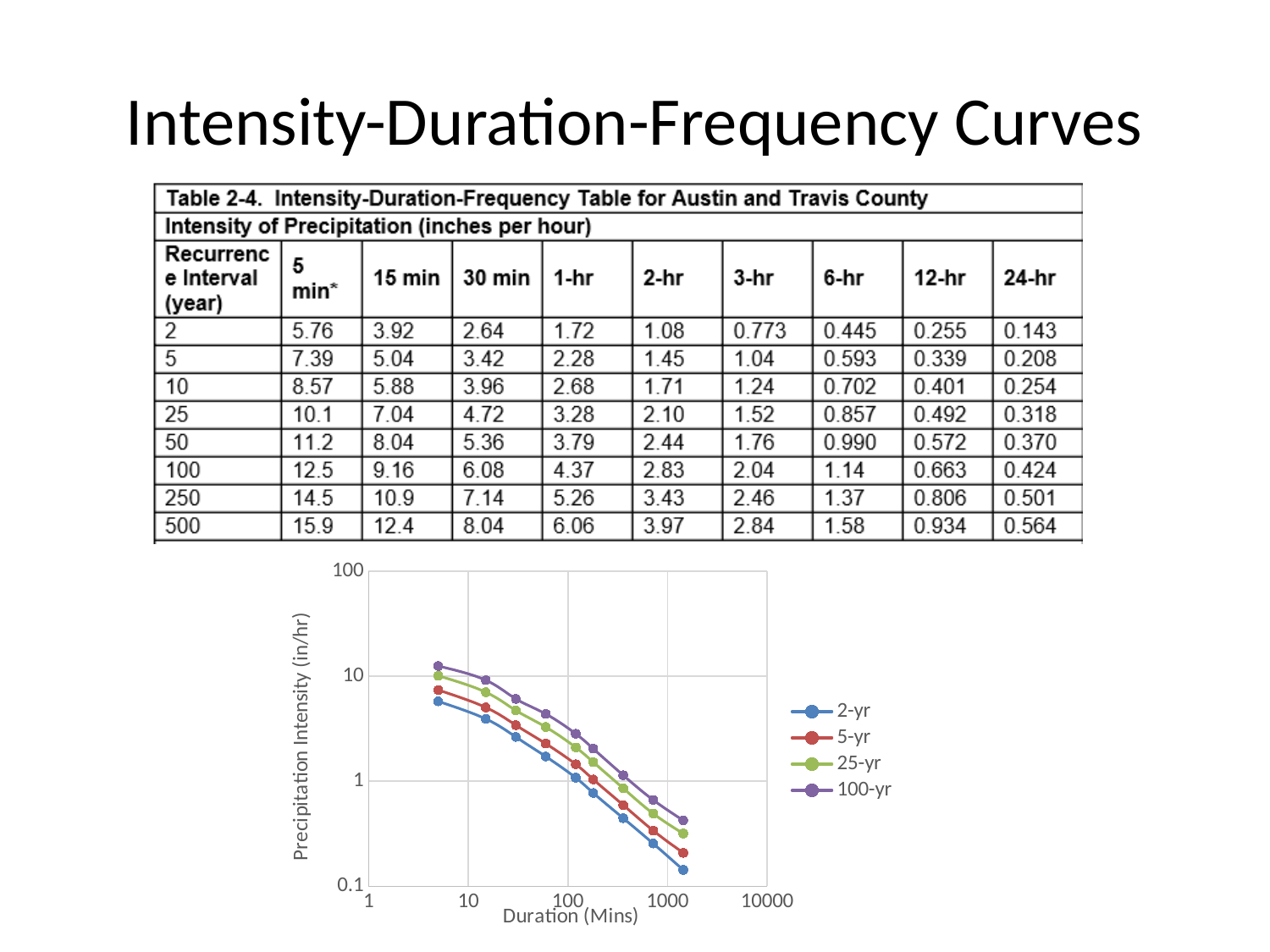
How many data points are plotted for the 2-yr series in the chart? 9 Which series in the chart has the highest precipitation intensity values? 100-yr What is the label of the x axis of the chart? Duration (Mins) In the chart, which series has the higher values at every duration, 2-yr or 100-yr? 100-yr What is the label of the y axis of the chart? Precipitation Intensity (in/hr) In the chart, is the 2-yr value at the longest duration greater or less than 1 in/hr? less How many series does the legend of the chart list? 4 In the chart, is the 100-yr value at the shortest duration greater or less than 10 in/hr? greater In the chart, is the 2-yr value at the shortest duration greater or less than 10 in/hr? less What kind of chart is shown below the table on the slide? line chart Which series in the chart has the lowest precipitation intensity values? 2-yr Do the values in the chart rise or fall as duration increases along the x axis? fall